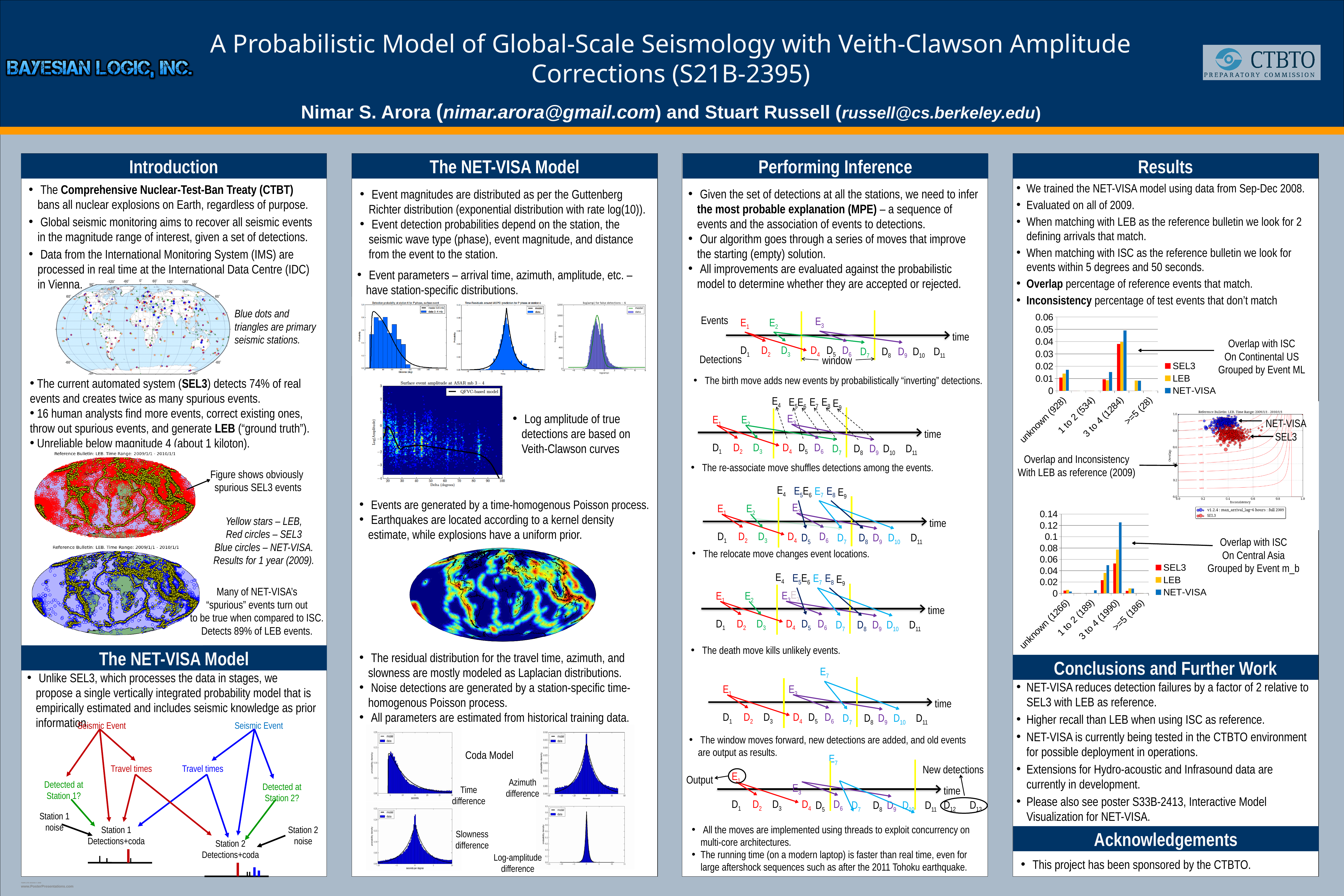
In the 'Overlap with ISC On Continental US Grouped by Event ML' chart, is the SEL3 value for '>=5 (28)' greater or less than 0.02? less In the 'Overlap with ISC On Central Asia Grouped by Event m_b' chart, which category has the highest NET-VISA value? 3 to 4 (1990) In the 'Overlap with ISC On Continental US Grouped by Event ML' chart, which category has the highest NET-VISA value? 3 to 4 (1284) In the 'Overlap with ISC On Central Asia Grouped by Event m_b' chart, is the NET-VISA value for '3 to 4 (1990)' greater or less than 0.1? greater In the 'Overlap with ISC On Central Asia Grouped by Event m_b' chart, which series is shown in blue according to the legend? NET-VISA In the 'Overlap with ISC On Central Asia Grouped by Event m_b' chart, for the category '3 to 4 (1990)', which is larger: the SEL3 value or the NET-VISA value? NET-VISA In the 'Overlap with ISC On Continental US Grouped by Event ML' chart, is the NET-VISA value for '3 to 4 (1284)' greater or less than 0.04? greater In the 'Overlap with ISC On Continental US Grouped by Event ML' chart, how many series does the legend list? 3 In the 'Overlap with ISC On Continental US Grouped by Event ML' chart, what kind of chart is shown? bar chart